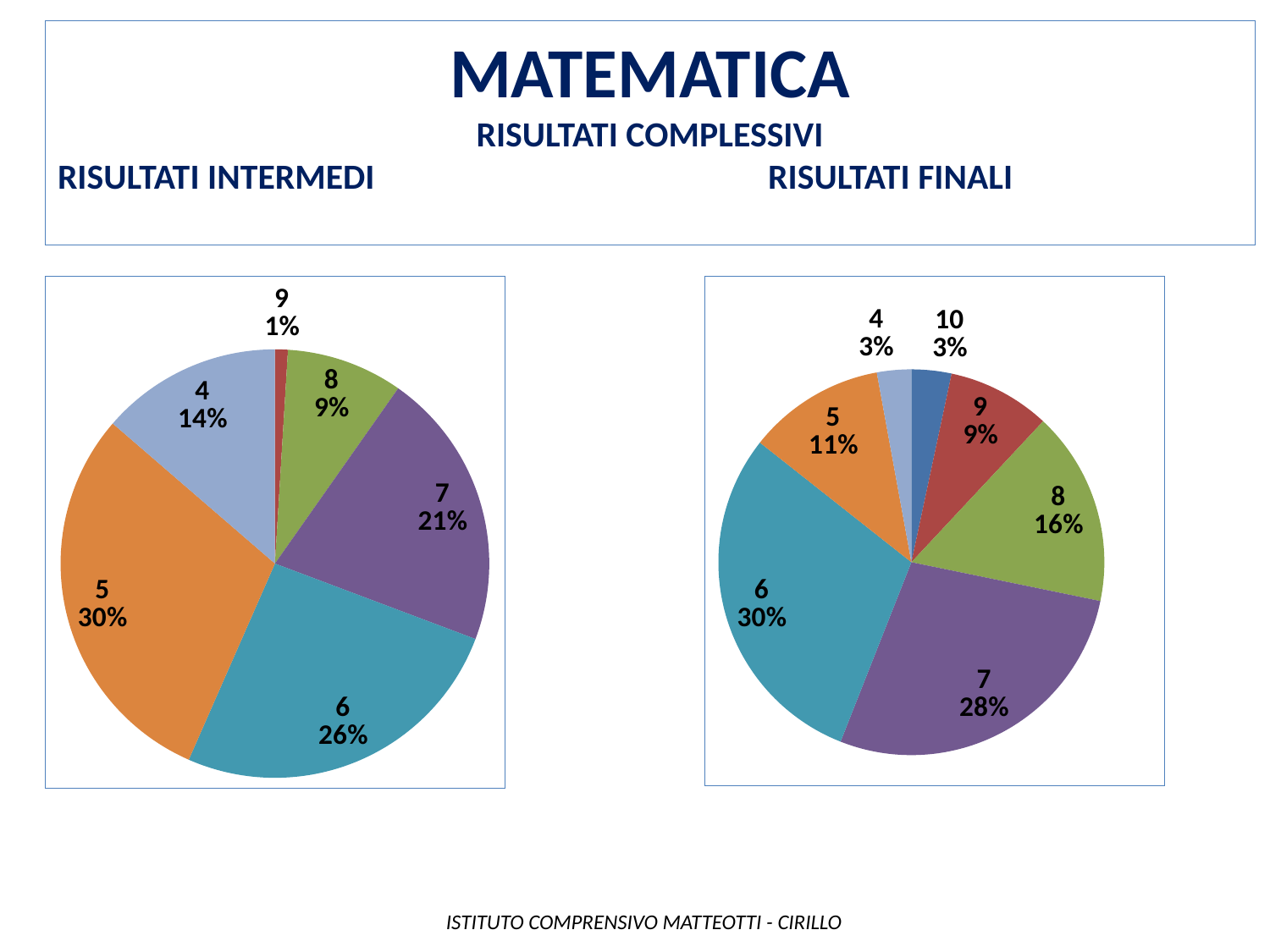
In the RISULTATI INTERMEDI pie chart, what share does grade 7 have? 21% In the RISULTATI FINALI pie chart, what share does grade 8 have? 16% What type of chart is used for the RISULTATI FINALI results? pie chart In the RISULTATI FINALI pie chart, how many slices are there? 7 In the RISULTATI FINALI pie chart, which is larger, the share of grade 7 or the share of grade 9? grade 7 In the RISULTATI FINALI pie chart, what share does grade 5 have? 11% In the RISULTATI INTERMEDI pie chart, which grade has the largest slice? 5 In the RISULTATI INTERMEDI pie chart, which grade has the smallest slice? 9 In the RISULTATI INTERMEDI pie chart, what is the difference between the shares of grade 6 and grade 4? 12% In the RISULTATI INTERMEDI pie chart, how many slices are there? 6 In the RISULTATI FINALI pie chart, which grade has the largest slice? 6